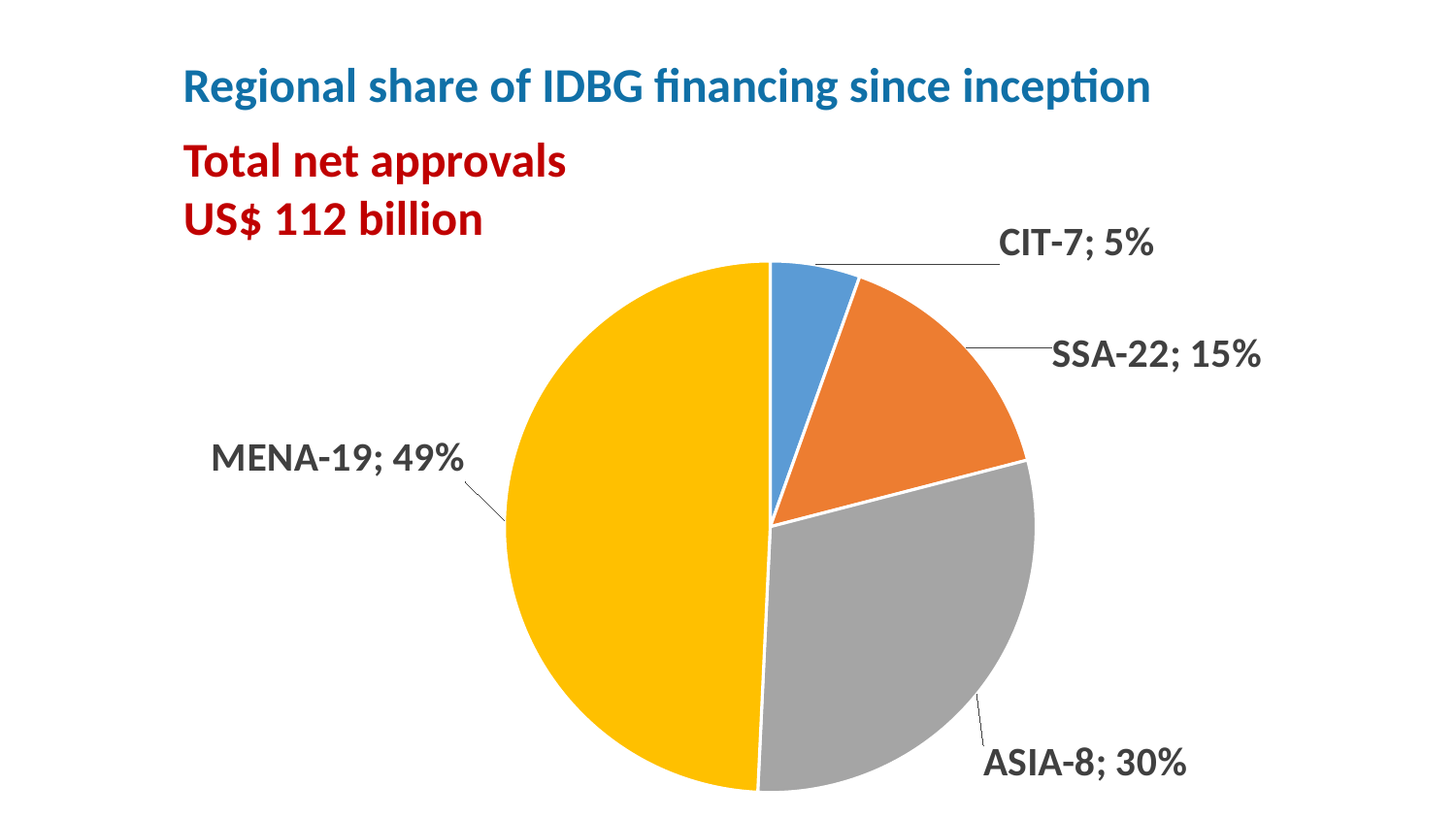
Which has a larger share of IDBG financing, SSA-22 or ASIA-8? ASIA-8 What share of IDBG financing does SSA-22 account for? 15% What share of IDBG financing does MENA-19 account for? 49% What is the difference in percentage points between the shares of MENA-19 and ASIA-8? 19 percentage points How many regions are shown in the pie chart? 4 What kind of chart is shown on the slide? Pie chart What share of IDBG financing does CIT-7 account for? 5% What is the title of the chart? Regional share of IDBG financing since inception Which region has the largest share of IDBG financing? MENA-19 What share of IDBG financing does ASIA-8 account for? 30% Which region has the smallest share of IDBG financing? CIT-7 What total net approvals amount is stated on the slide? US$ 112 billion